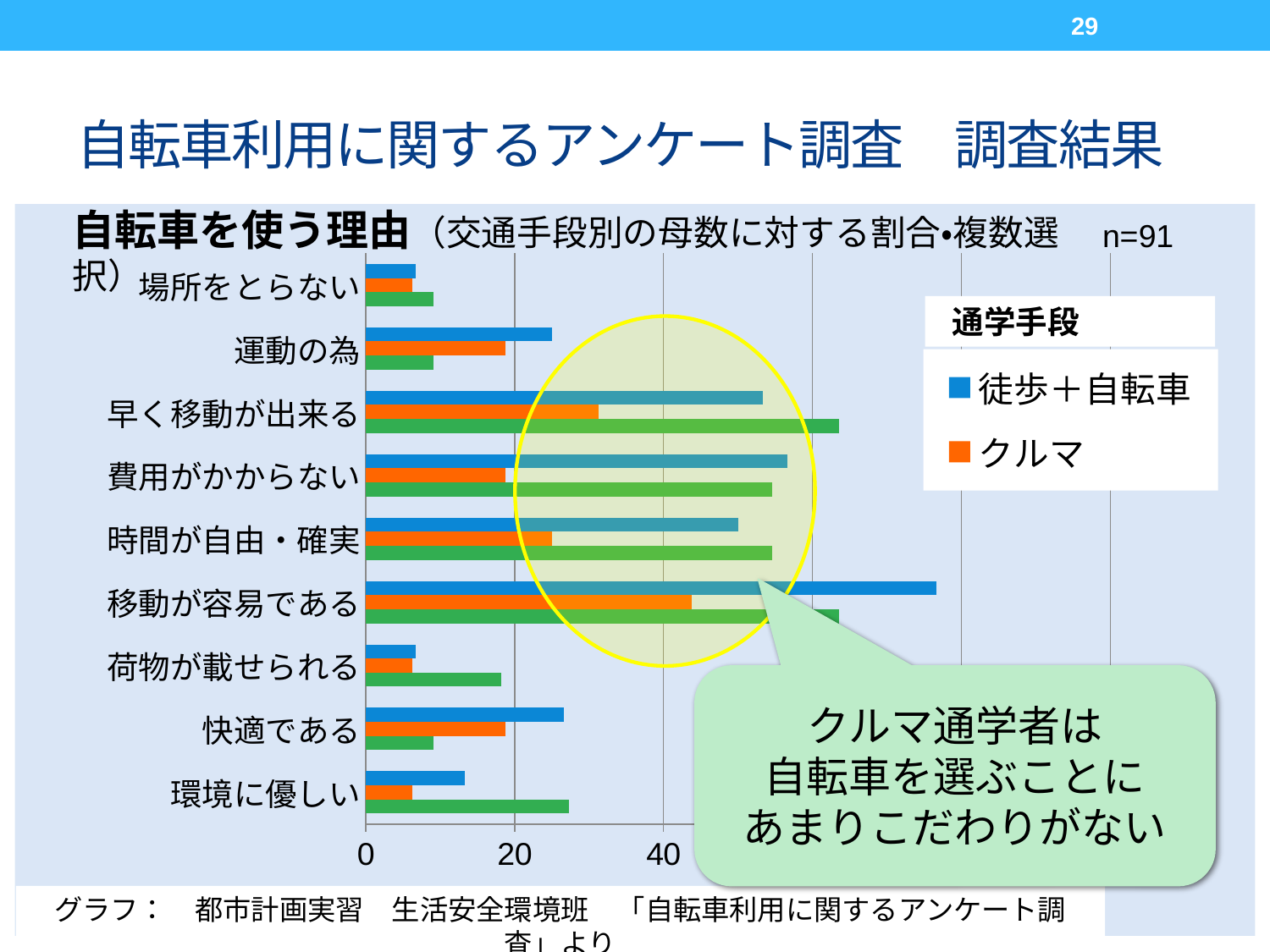
What colour represents the クルマ series in the legend? orange Which category has the highest value for the クルマ series? 移動が容易である What is the sample size (n) shown next to the chart title? n=91 How many series does the visible legend (通学手段) list? 2 Is the クルマ value for 早く移動が出来る greater or less than 40? less What kind of chart is shown on the slide? bar chart How many reason categories are listed on the vertical axis of the chart? 9 Is the 徒歩＋自転車 value for 運動の為 greater or less than 20? greater Which category has the highest value for the 徒歩＋自転車 series? 移動が容易である Is the 徒歩＋自転車 value for 環境に優しい greater or less than 20? less For 環境に優しい, which series has the larger value, 徒歩＋自転車 or クルマ? 徒歩＋自転車 For 運動の為, which series has the larger value, 徒歩＋自転車 or クルマ? 徒歩＋自転車